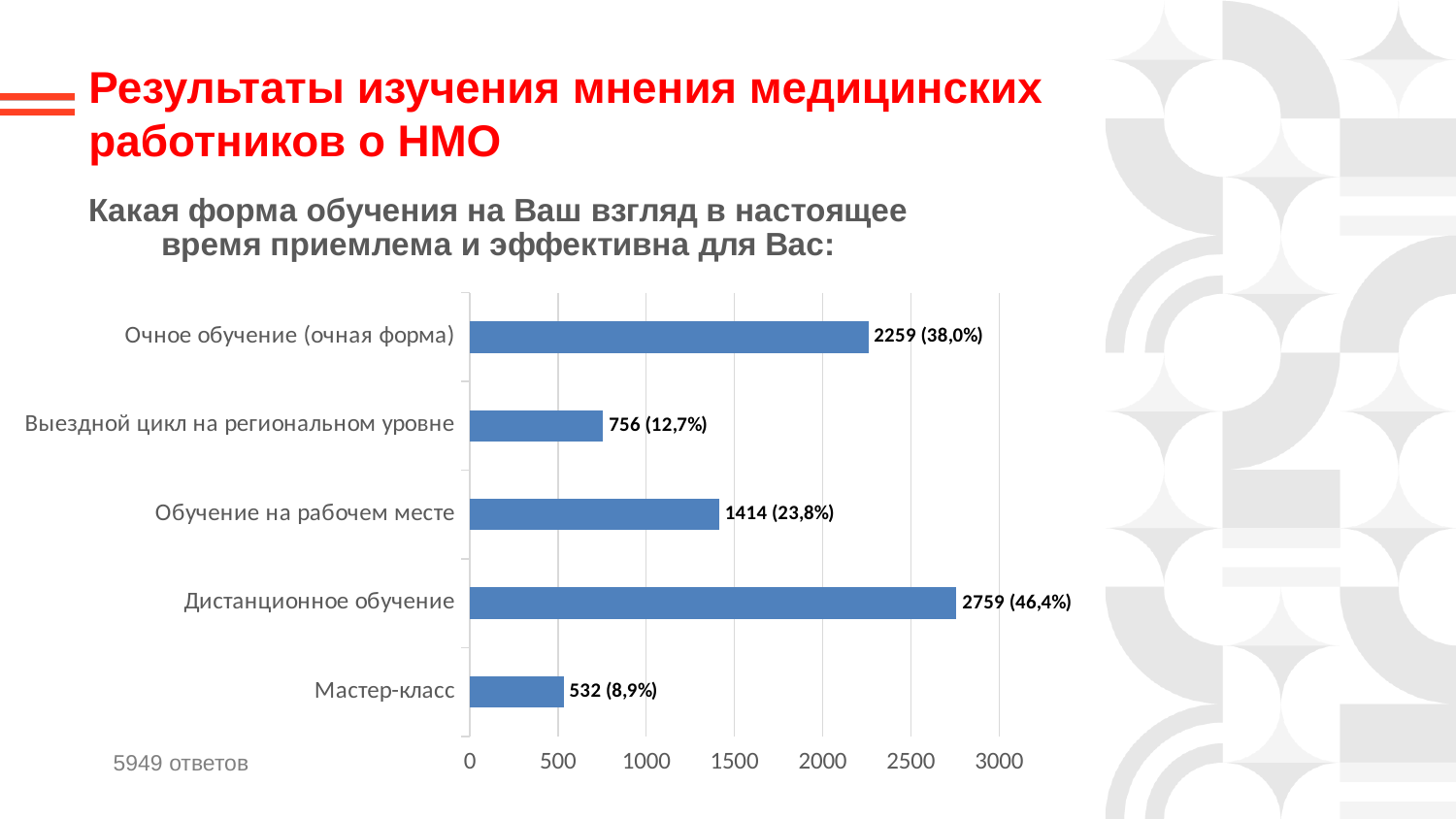
What is the value shown for Обучение на рабочем месте? 1414 (23,8%) Which category has the highest value? Дистанционное обучение What is the value shown for Мастер-класс? 532 (8,9%) What is the difference between the counts for Выездной цикл на региональном уровне and Мастер-класс? 224 Which category has the lowest value? Мастер-класс How many responses does the note below the chart say were collected? 5949 ответов Which is larger: the value for Выездной цикл на региональном уровне or the value for Обучение на рабочем месте? Обучение на рабочем месте Is the value for Очное обучение (очная форма) greater or less than 2000? greater What is the value shown for Дистанционное обучение? 2759 (46,4%) What kind of chart is shown on the slide? bar chart What is the difference between the counts for Дистанционное обучение and Очное обучение (очная форма)? 500 How many categories are shown in the chart? 5